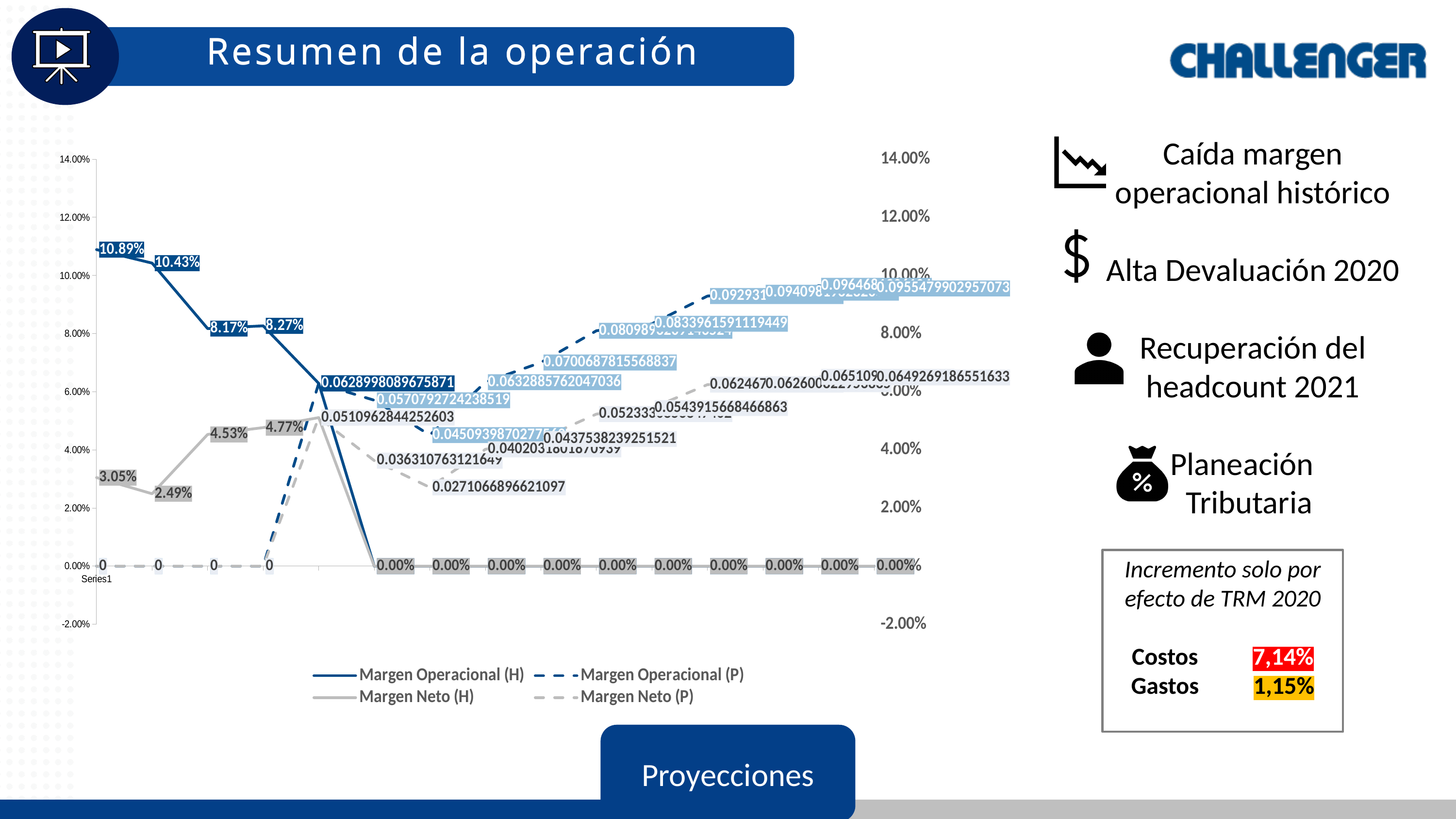
What is the difference between the first two labelled values on the Margen Operacional (H) line, 10.89% and 10.43%? 0.46% How many series does the chart legend list? 4 What is the value of the first data label on the Margen Neto (H) line? 3.05% What is the value of the first data label on the Margen Operacional (H) line? 10.89% What kind of chart is shown on the slide? line chart What is the highest labelled value on the Margen Operacional (H) line? 10.89% What is the lowest labelled percentage value on the Margen Neto (H) line before it drops to 0.00%? 2.49% What is the value of the second data label on the Margen Operacional (H) line? 10.43% Which is larger on the Margen Operacional (H) line: the third labelled value (8.17%) or the fourth labelled value (8.27%)? 8.27% What is the value of the fourth data label on the Margen Neto (H) line? 4.77% Is the last point of the Margen Operacional (P) dashed line greater or less than 8.00%? greater Does the Margen Operacional (H) line rise or fall across its first four labelled points? fall